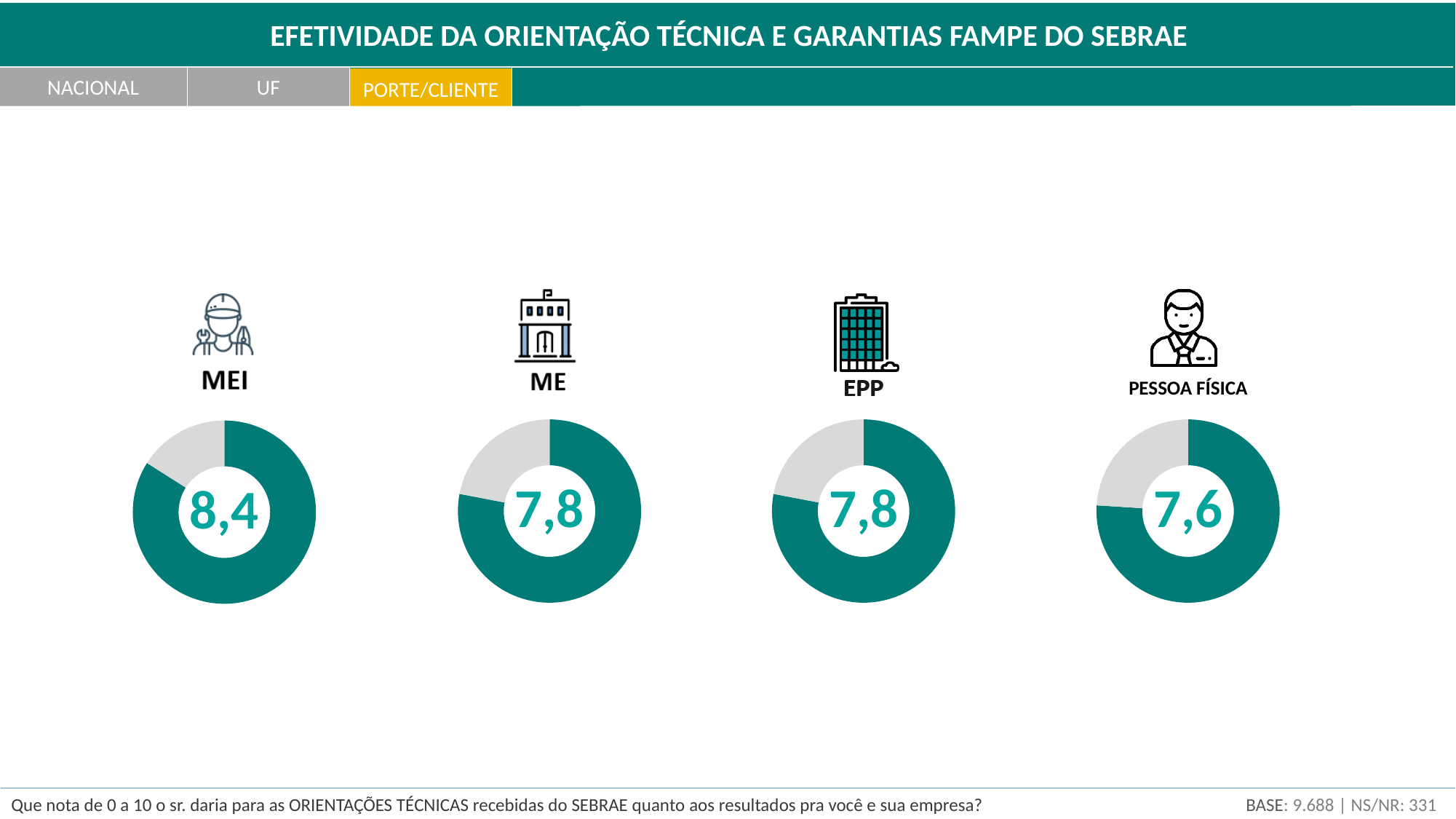
Which group has the highest score among the donut charts? MEI What score is shown in the EPP donut chart? 7,8 Which has a higher score, EPP or PESSOA FÍSICA? EPP What is the difference between the MEI score and the ME score? 0,6 What is the difference between the MEI score and the PESSOA FÍSICA score? 0,8 What score is shown in the ME donut chart? 7,8 What score is shown in the MEI donut chart? 8,4 How many donut charts are shown on the slide? 4 What kind of chart is used to display each group's score? Donut (pie) chart Which has a higher score, MEI or ME? MEI What score is shown in the PESSOA FÍSICA donut chart? 7,6 Which group has the lowest score among the donut charts? PESSOA FÍSICA